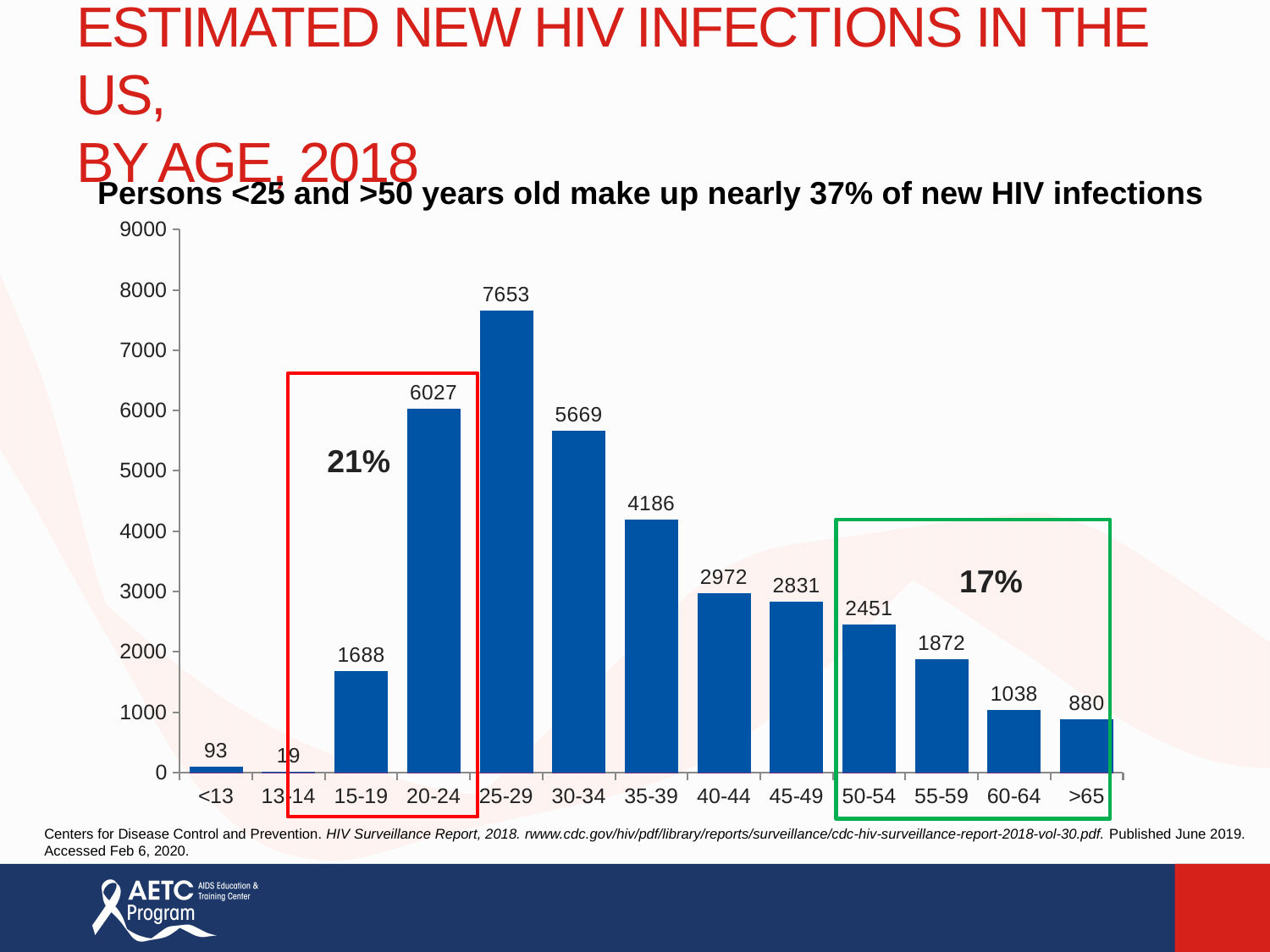
What is the estimated number of new HIV infections for the 25-29 age group? 7653 Is the value for the 40-44 age group greater or less than 3000? less Which age group has a larger value, 30-34 or 35-39? 30-34 What is the estimated number of new HIV infections for the 60-64 age group? 1038 What kind of chart is shown on the slide? bar chart How many age groups are shown on the x axis? 13 Which age group has the highest number of estimated new HIV infections? 25-29 Do the values rise or fall along the x axis from the 25-29 age group to the >65 age group? fall What percentage is labelled inside the green box on the chart? 17% What is the difference between the values for the 20-24 and 15-19 age groups? 4339 What is the value shown for the >65 age group? 880 Which age group has the lowest number of estimated new HIV infections? 13-14